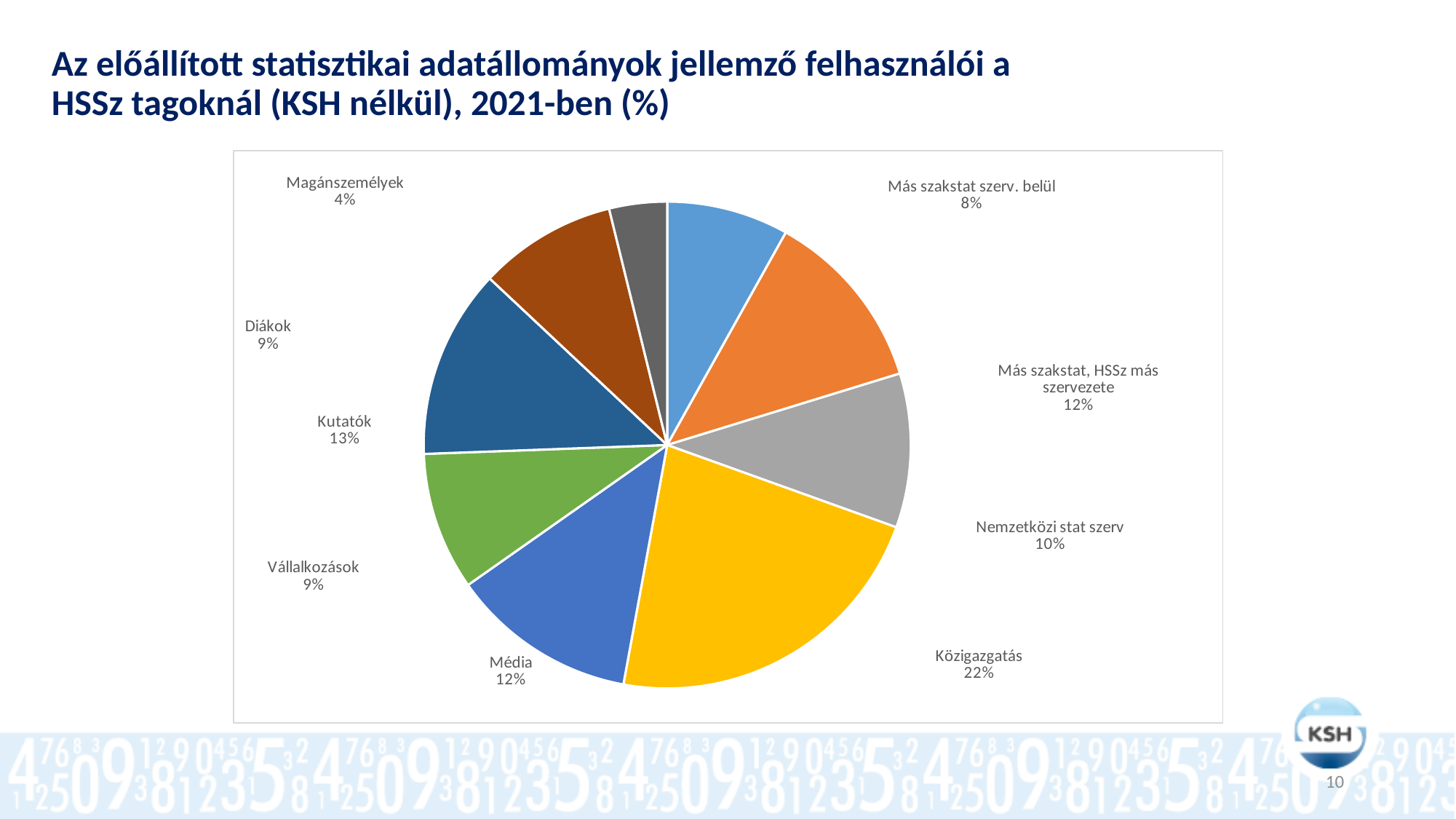
How many slices does the pie chart have? 9 What is the difference between the shares of Más szakstat, HSSz más szervezete and Más szakstat szerv. belül? 4 percentage points What is the value for Kutatók? 13% What kind of chart is shown on the slide? pie chart What colour is the Közigazgatás slice? yellow What is the value for Nemzetközi stat szerv? 10% Which category has the largest slice of the pie? Közigazgatás What is the value for Magánszemélyek? 4% What share of the pie does Közigazgatás have? 22% Which category has the smallest slice of the pie? Magánszemélyek Which is larger, the share for Média or the share for Vállalkozások? Média What is the difference between the shares of Közigazgatás and Kutatók? 9 percentage points